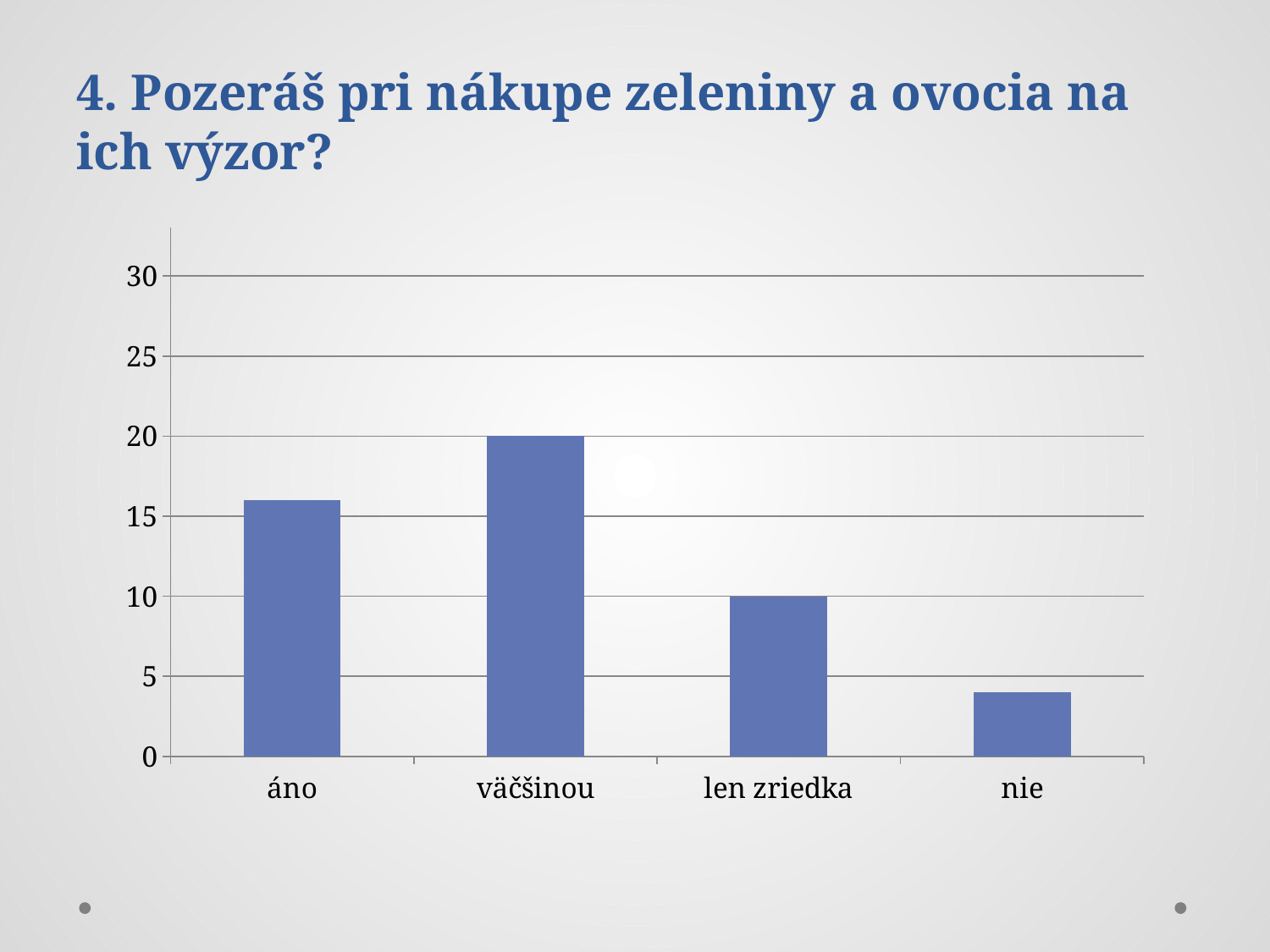
What is the highest value shown on the vertical axis? 30 What is the value for len zriedka? 10 What is the difference between the values for väčšinou and len zriedka? 10 Which category has the highest value? väčšinou What kind of chart is shown on the slide? bar chart Is the value for áno greater or less than 15? greater What is the value for väčšinou? 20 Is the value for nie greater or less than 5? less Which is larger, the value for len zriedka or the value for nie? len zriedka How many categories are shown on the x axis? 4 Which category has the lowest value? nie Which is larger, the value for áno or the value for väčšinou? väčšinou